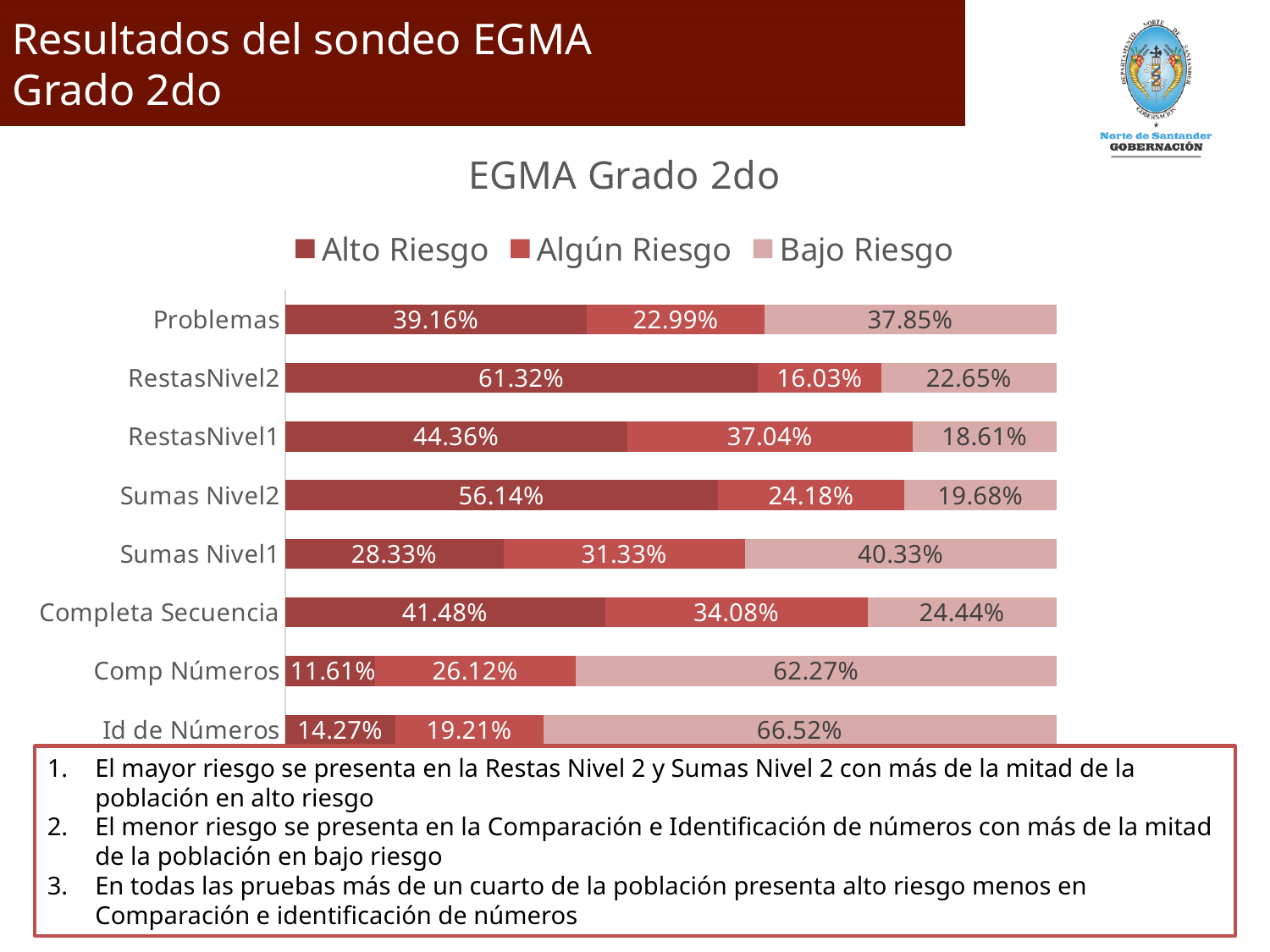
Which is larger: the Algún Riesgo value for RestasNivel1 or for Sumas Nivel1? RestasNivel1 What is the Alto Riesgo value for RestasNivel2? 61.32% What is the Algún Riesgo value for Completa Secuencia? 34.08% Which category has the highest Alto Riesgo value? RestasNivel2 What is the Bajo Riesgo value for Comp Números? 62.27% Which category has the highest Bajo Riesgo value? Id de Números What kind of chart is shown on the slide? Stacked bar chart How many categories are shown on the chart? 8 What is the difference between the Alto Riesgo values for RestasNivel2 and Sumas Nivel2? 5.18% Which category has the lowest Alto Riesgo value? Comp Números How many series does the legend list? 3 What is the title of the chart? EGMA Grado 2do